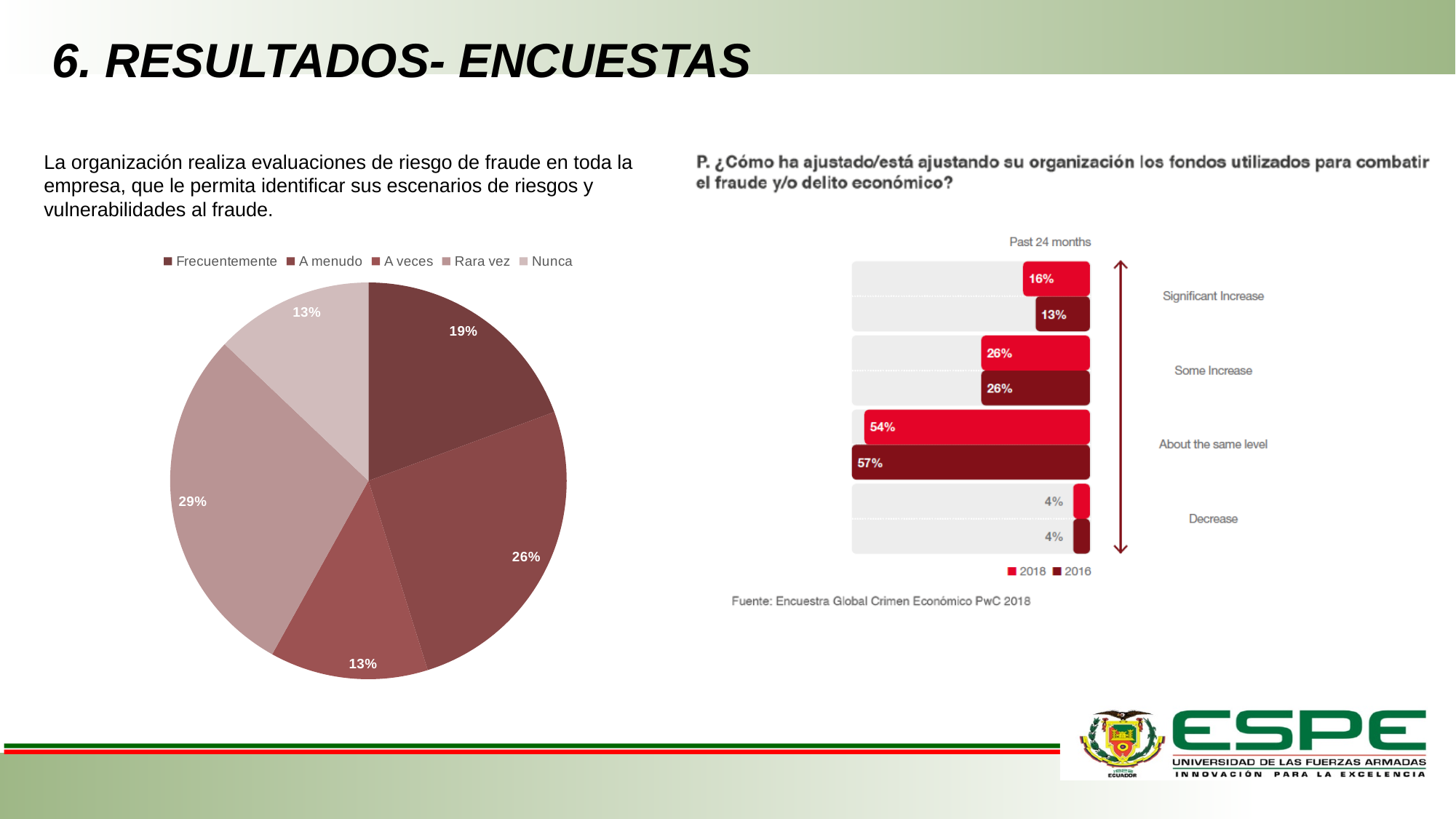
What kind of chart is shown on the left of the slide? Pie chart On the bar chart on the right, what is the 2018 value for About the same level? 54% On the bar chart on the right, what is the difference between the 2016 and 2018 values for About the same level? 3% On the bar chart on the right, which category has the highest value for 2016? About the same level On the pie chart on the left, how many categories does the legend list? 5 On the pie chart on the left, what share does Rara vez have? 29% On the bar chart on the right, which is larger for Significant Increase: the 2018 value or the 2016 value? 2018 On the bar chart on the right, how many series does the legend list? 2 On the pie chart on the left, which category has the largest share? Rara vez On the bar chart on the right, what is the 2016 value for Significant Increase? 13% On the pie chart on the left, what share does Frecuentemente have? 19% On the pie chart on the left, what is the difference between the shares of A menudo and A veces? 13%